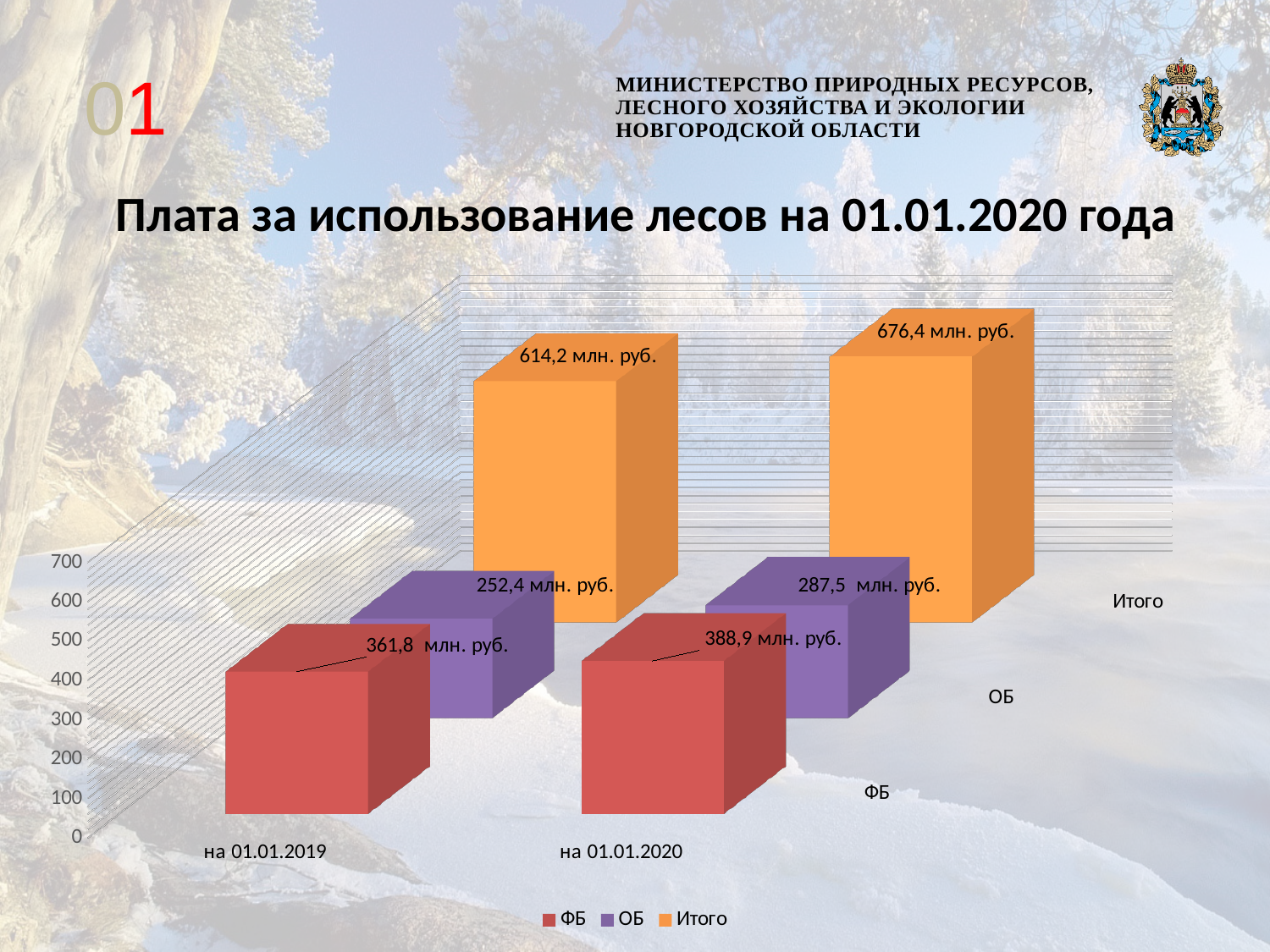
How many series does the legend list? 3 Which is larger: ОБ on 01.01.2019 or ОБ on 01.01.2020? ОБ on 01.01.2020 Which series has the highest value on 01.01.2020? Итого What is the value for Итого on 01.01.2019? 614,2 млн. руб. What is the difference between the ФБ values on 01.01.2020 and 01.01.2019? 27,1 млн. руб. What is the difference between the Итого values on 01.01.2020 and 01.01.2019? 62,2 млн. руб. Does the ФБ value rise or fall from 01.01.2019 to 01.01.2020? Rise What is the value for ОБ on 01.01.2020? 287,5 млн. руб. What is the value for Итого on 01.01.2020? 676,4 млн. руб. What is the value for ФБ on 01.01.2019? 361,8 млн. руб. What kind of chart is shown on the slide? Bar chart Which series has the lowest value on 01.01.2019? ОБ